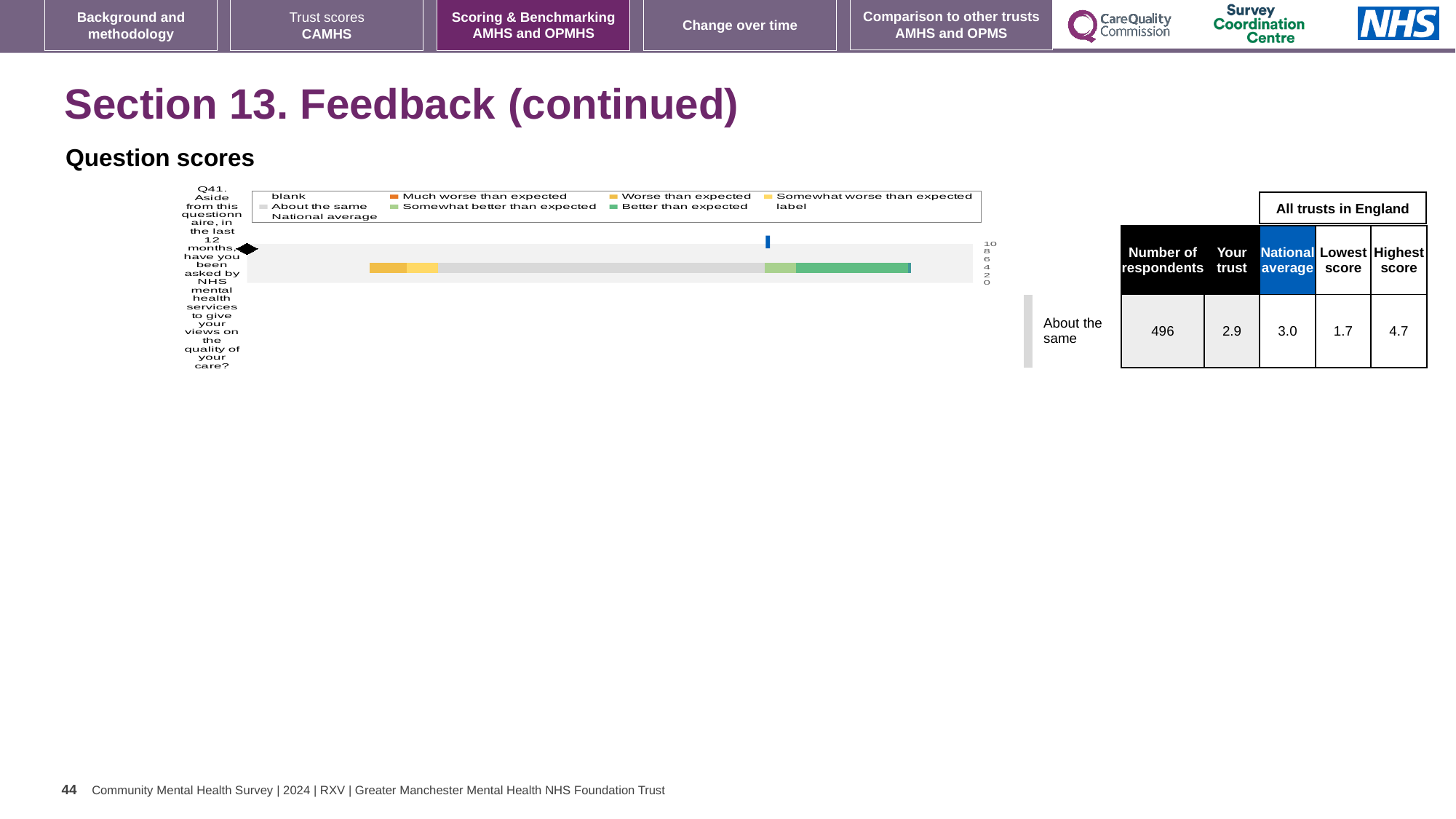
Which question number is plotted in the bar chart? Q41 In the table beside the chart, what is the national average score for Q41? 3.0 In the table beside the chart, what is the number of respondents for Q41? 496 What is the difference between the highest score and the lowest score for Q41 in the table? 3.0 In the table beside the chart, what is the 'Your trust' score for Q41? 2.9 Which legend entry is shown in dark green in the bar chart? Better than expected In the table beside the chart, what is the lowest score among all trusts in England for Q41? 1.7 Which is larger for Q41, the 'Your trust' score or the national average? National average In the table beside the chart, what is the highest score among all trusts in England for Q41? 4.7 How many questions (categories) are plotted in the bar chart? 1 According to the label beside the chart, how is the trust's result for Q41 categorised? About the same What kind of chart is shown for Q41 on this slide? Bar chart